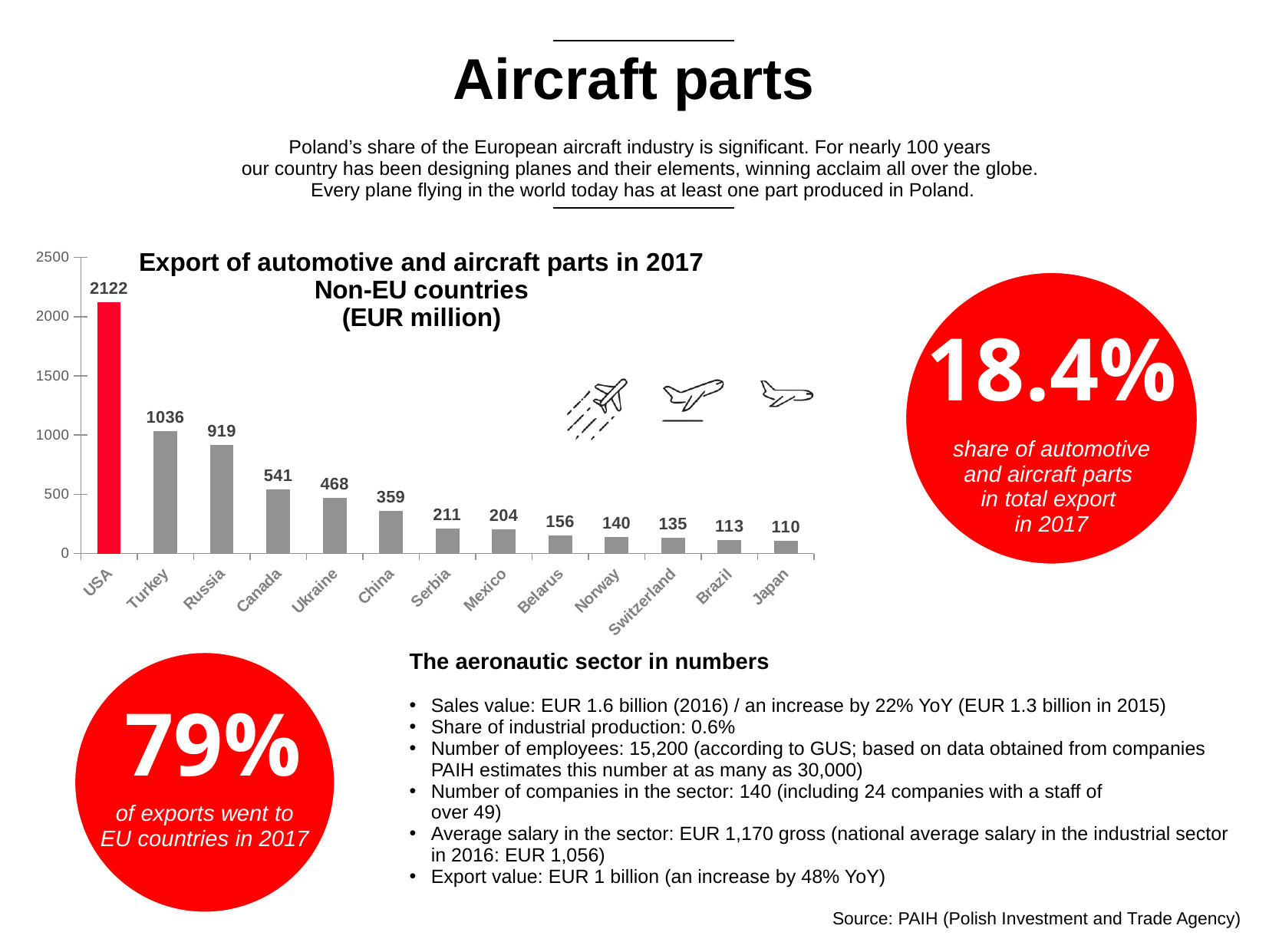
What is the difference between the export values for USA and Turkey? 1086 Which has a larger export value, Ukraine or Serbia? Ukraine Is the export value for Mexico greater or less than 500? less How many countries are shown in the chart? 13 What is the export value for Turkey in the chart? 1036 What kind of chart is used to show the export of automotive and aircraft parts? bar chart What is the difference between the export values for Russia and China? 560 What is the export value for Canada? 541 Which country has the highest export value in the chart? USA What unit is given in the chart title for the export values? EUR million What is the export value for Switzerland? 135 Which country has the lowest export value in the chart? Japan